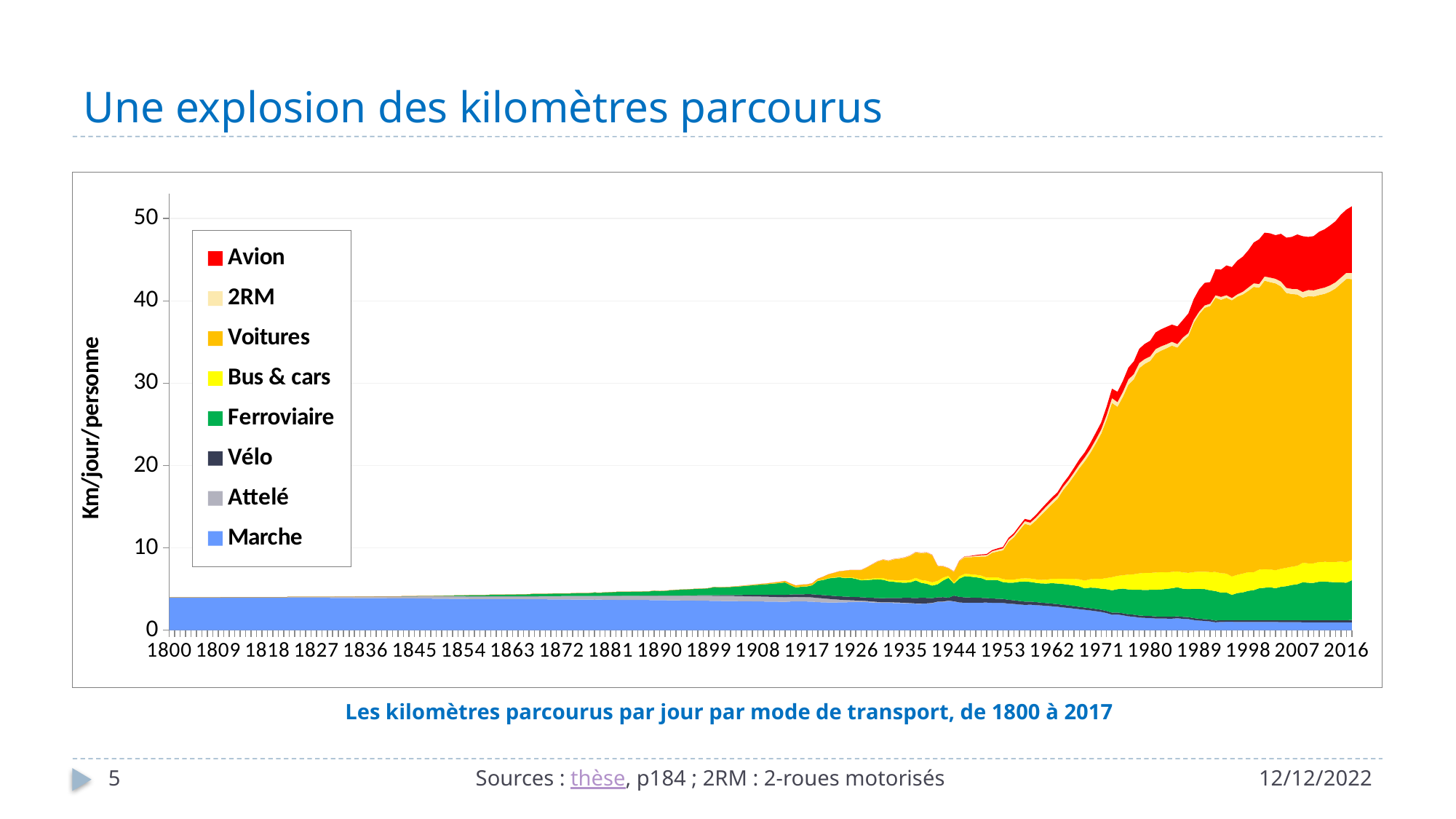
Is the total value in 1944 greater or less than 10? less Which series is listed first in the legend? Avion How many series does the legend list? 8 What kind of chart is shown on the slide? Stacked area chart Which mode of transport accounts for the largest share of kilometres in 2016? Voitures Is the total value in 1980 greater or less than 30? greater Is the total value in 2016 greater or less than 40? greater Does the total kilometres per day per person rise or fall from 1800 to 2016? Rise Which is larger in 2016, the value for Voitures or the value for Avion? Voitures Which mode of transport accounts for almost all kilometres travelled in 1800? Marche What is the label of the vertical axis? Km/jour/personne